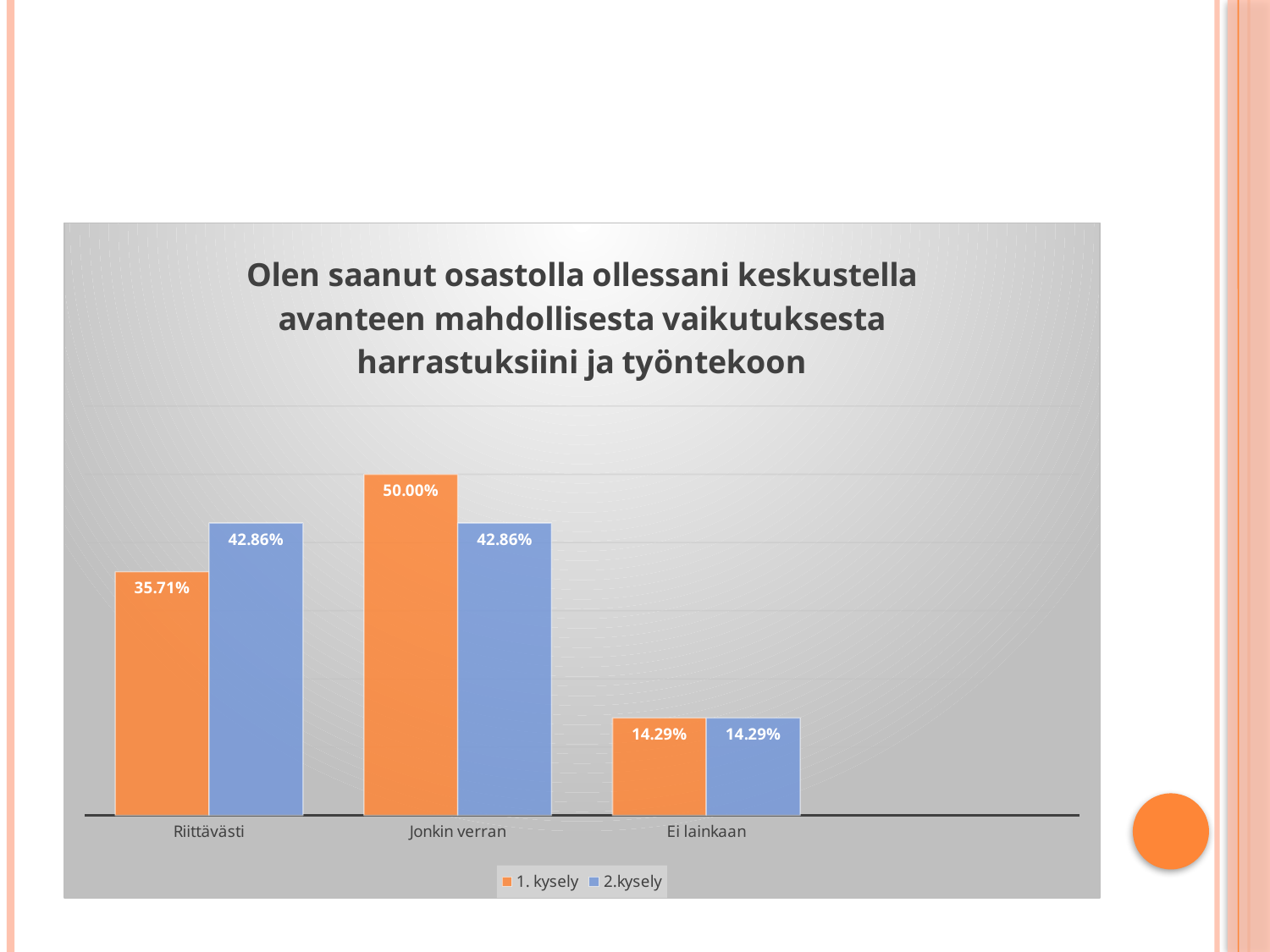
How many categories are shown on the x axis? 3 How many series does the legend list? 2 What is the value for Jonkin verran in the 2.kysely series? 42.86% Which category has the highest value in the 1. kysely series? Jonkin verran What is the difference between the 1. kysely and 2.kysely values for Riittävästi? 7.15% Which category has the lowest value in the 2.kysely series? Ei lainkaan What is the difference between the 1. kysely value for Jonkin verran and the 1. kysely value for Riittävästi? 14.29% What kind of chart is shown on the slide? Bar chart For Jonkin verran, which series has the larger value, 1. kysely or 2.kysely? 1. kysely What is the value for Ei lainkaan in the 1. kysely series? 14.29% What is the value for Riittävästi in the 1. kysely series? 35.71% Which colour represents the 2.kysely series? Blue